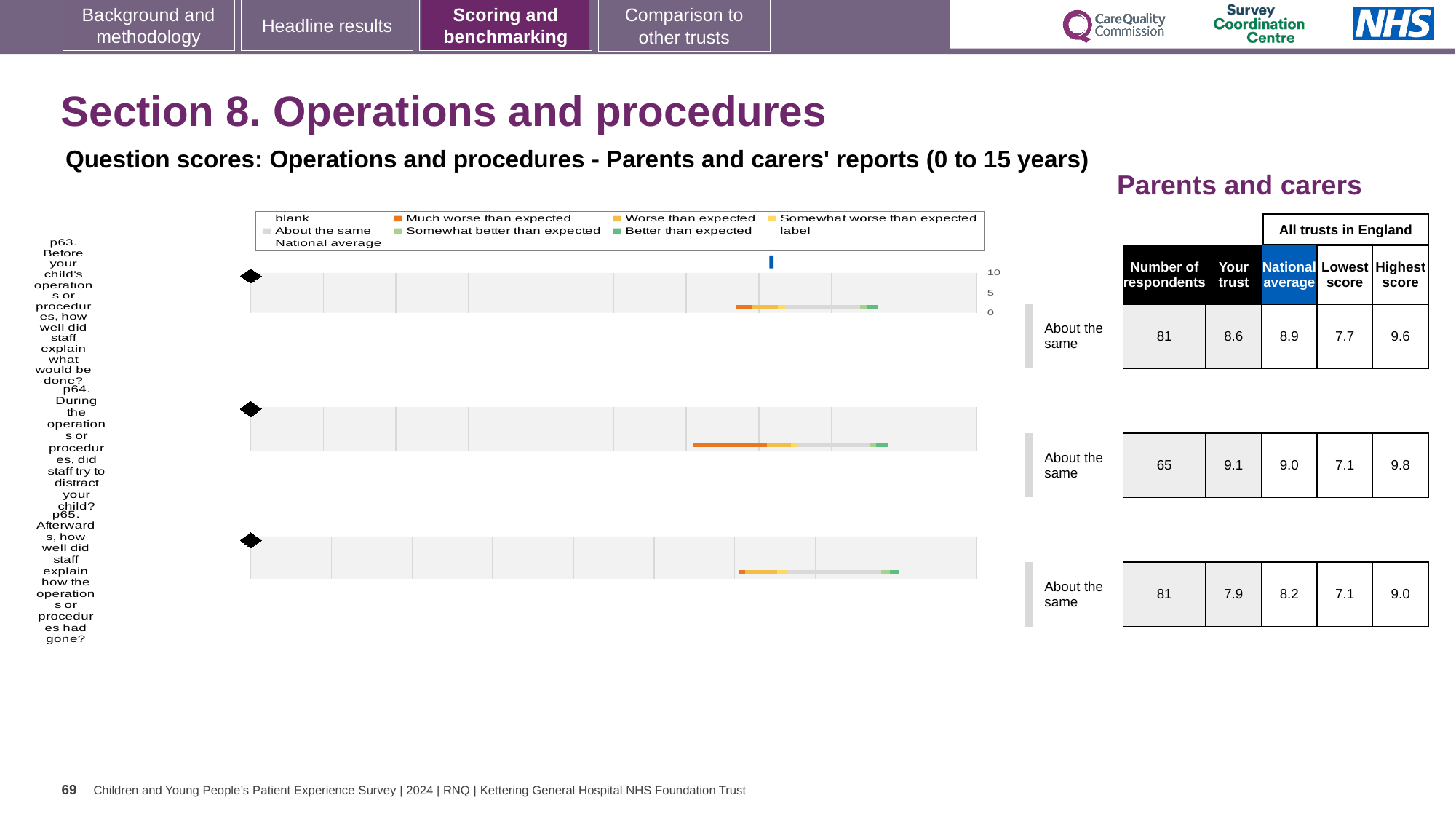
What is the lowest score across all trusts in England for question p63? 7.7 Which question has the highest 'Your trust' score? p64 What benchmark category is shown for question p65? About the same Which question has the lowest 'Your trust' score? p65 For question p64, which is larger: the 'Your trust' score or the national average? Your trust What is the highest score across all trusts in England for question p65 (how well staff explained how the operation had gone)? 9.0 For question p63, what is the difference between the national average and the 'Your trust' score? 0.3 What is the 'Your trust' score for question p63 (how well staff explained what would be done before the operation)? 8.6 How many respondents answered question p64? 65 Is the 'Your trust' score for question p65 greater or less than 5 on the chart axis? greater What is the national average score for question p64 (did staff try to distract your child during the operation)? 9.0 How many questions are plotted on this slide? 3